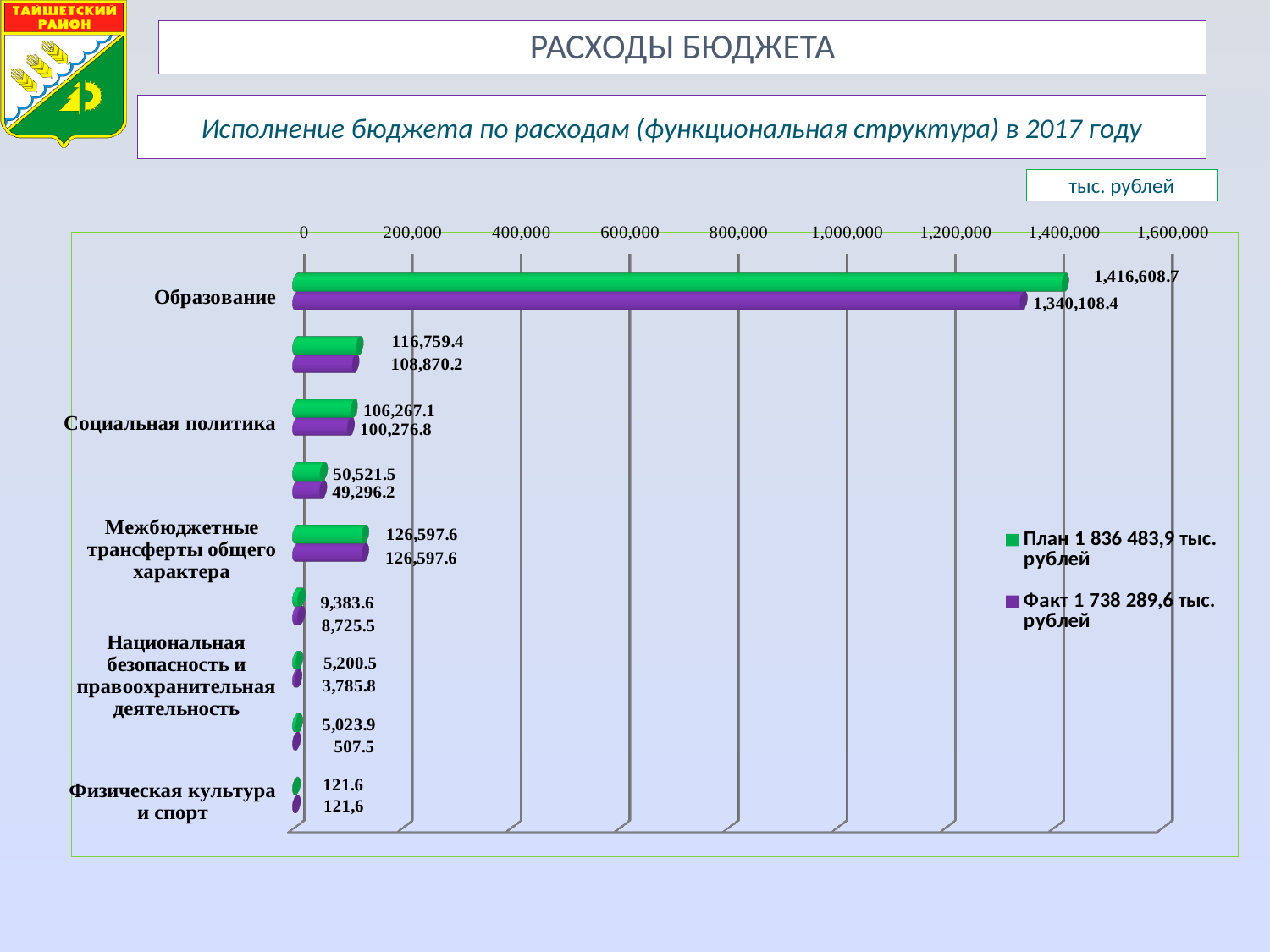
What is the План value for Образование? 1,416,608.7 What is the difference between the План and Факт values for Социальная политика? 5,990.3 Which category has the highest План value? Образование What kind of chart is shown on the slide? Bar chart What is the Факт value for Национальная безопасность и правоохранительная деятельность? 3,785.8 Which labelled category has the lowest Факт value? Физическая культура и спорт What is the difference between the План and Факт values for Образование? 76,500.3 What is the Факт value for Образование? 1,340,108.4 How many series does the legend list? 2 What is the Факт value for Межбюджетные трансферты общего характера? 126,597.6 What is the План value for Социальная политика? 106,267.1 Which is larger for Социальная политика, the План value or the Факт value? План